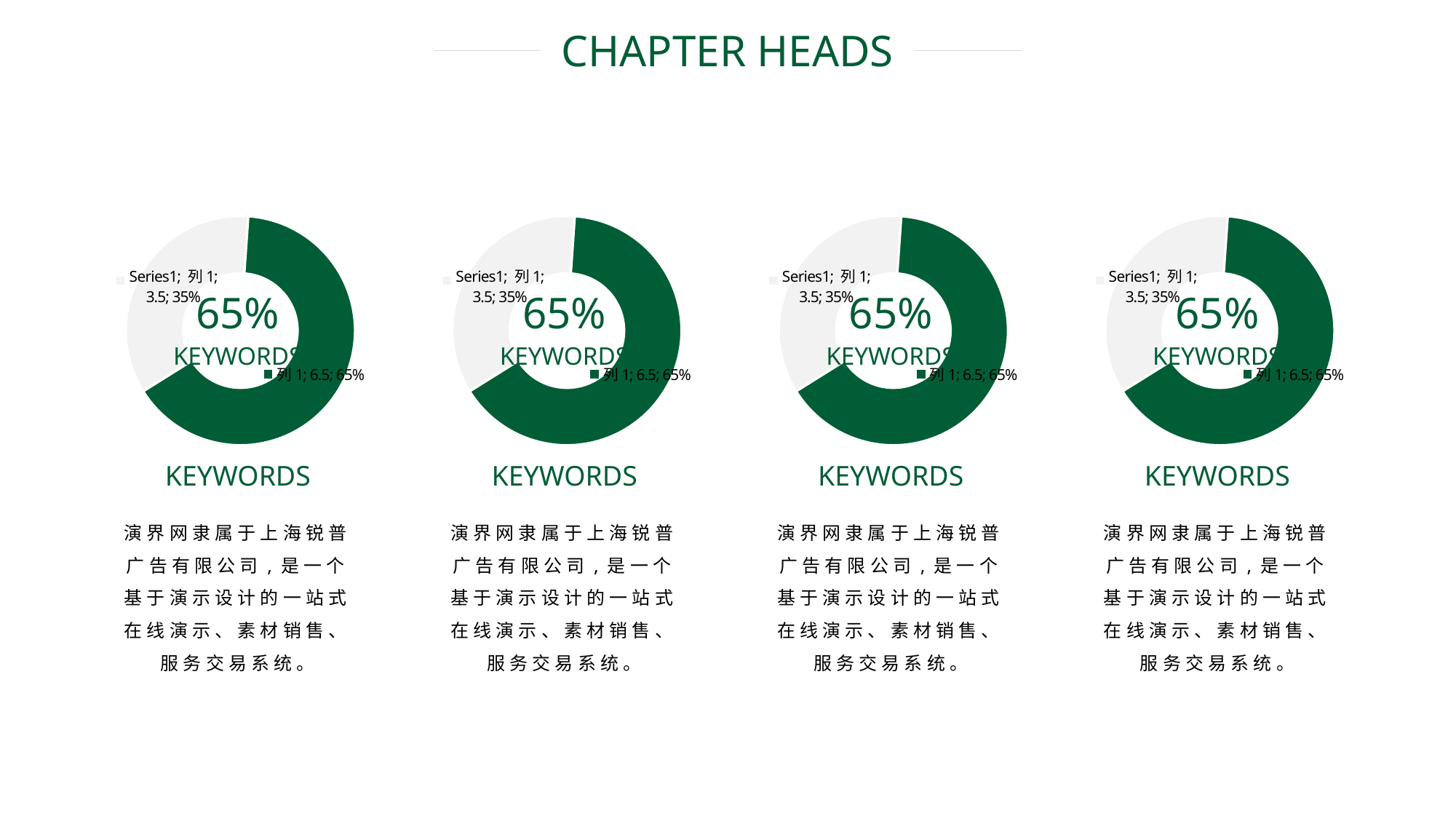
What kind of chart is the leftmost chart on the slide? Doughnut chart How many slices does the leftmost doughnut chart have? 2 In the second chart from the left, what percentage does the light grey slice represent? 35% In the leftmost chart, what percentage does the green slice represent? 65% In the third chart from the left, what value is shown for the green slice? 6.5 In the third chart from the left, what is the total of the two slice values? 10 How many doughnut charts are shown on the slide? 4 In the rightmost chart, what value is shown for the light grey slice? 3.5 In the rightmost chart, which slice is larger, the green one or the light grey one? The green one What is the title at the top of the slide? CHAPTER HEADS In the second chart from the left, what is the difference between the two slice values, 6.5 and 3.5? 3 What percentage is printed in the centre of the leftmost doughnut chart? 65%